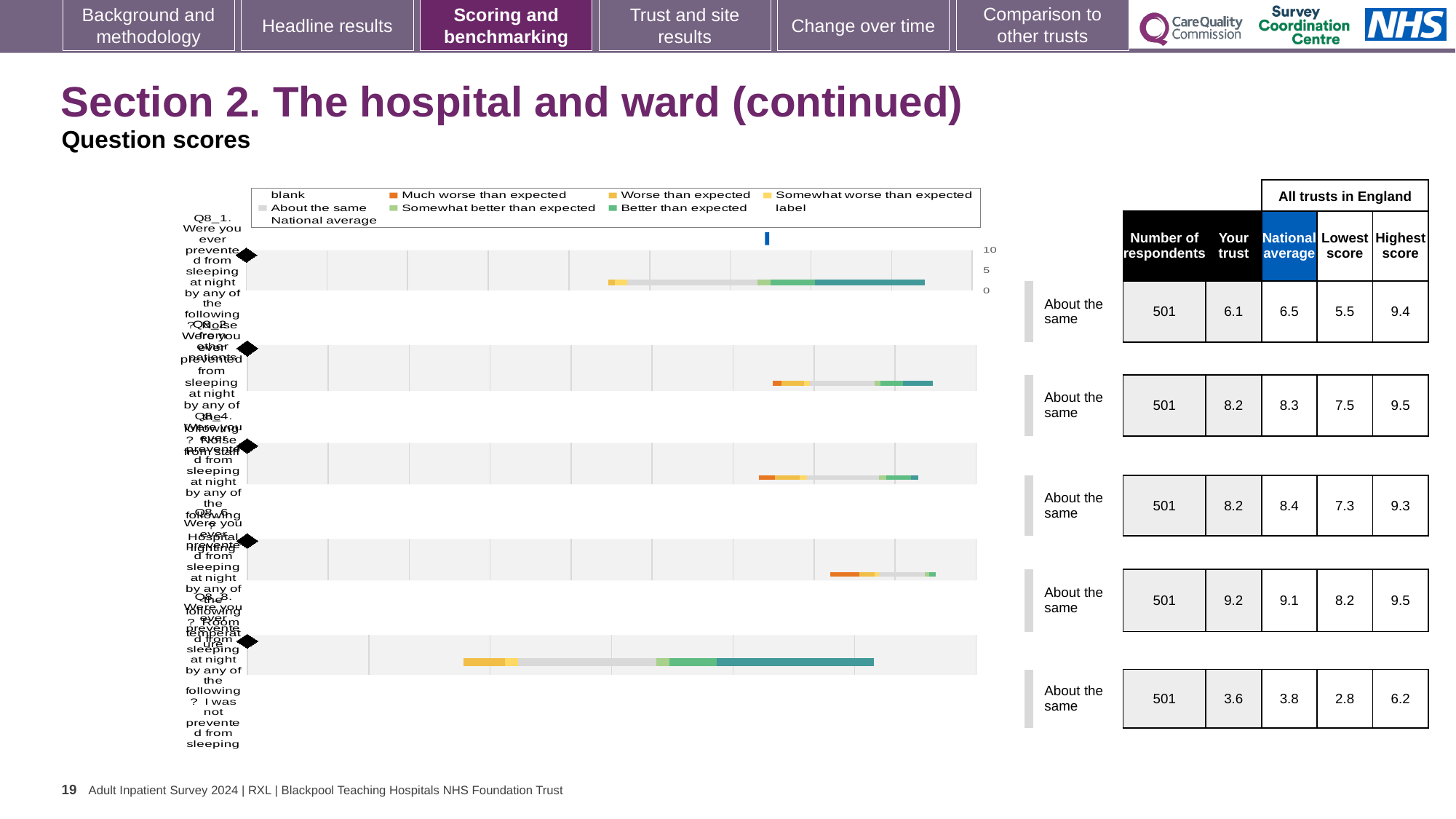
What kind of chart is used to show the question scores on this slide? Bar chart How many respondents are shown for each question row? 501 How many question rows (bars) are plotted in the chart? 5 For the top question row, how much higher is the national average than the 'Your trust' score? 0.4 What benchmark category label is shown next to every question row? About the same Which question row has the highest 'Your trust' score? The fourth row (9.2) What is the national average for the bottom (fifth) question row? 3.8 For the bottom question row, which is larger: the 'Your trust' score or the national average? National average Which question row has the lowest 'Your trust' score? The bottom row (3.6) What is the 'Your trust' score for the top (first) question row? 6.1 What is the highest score among all trusts in England for the second question row? 9.5 How many entries does the chart legend list? 9